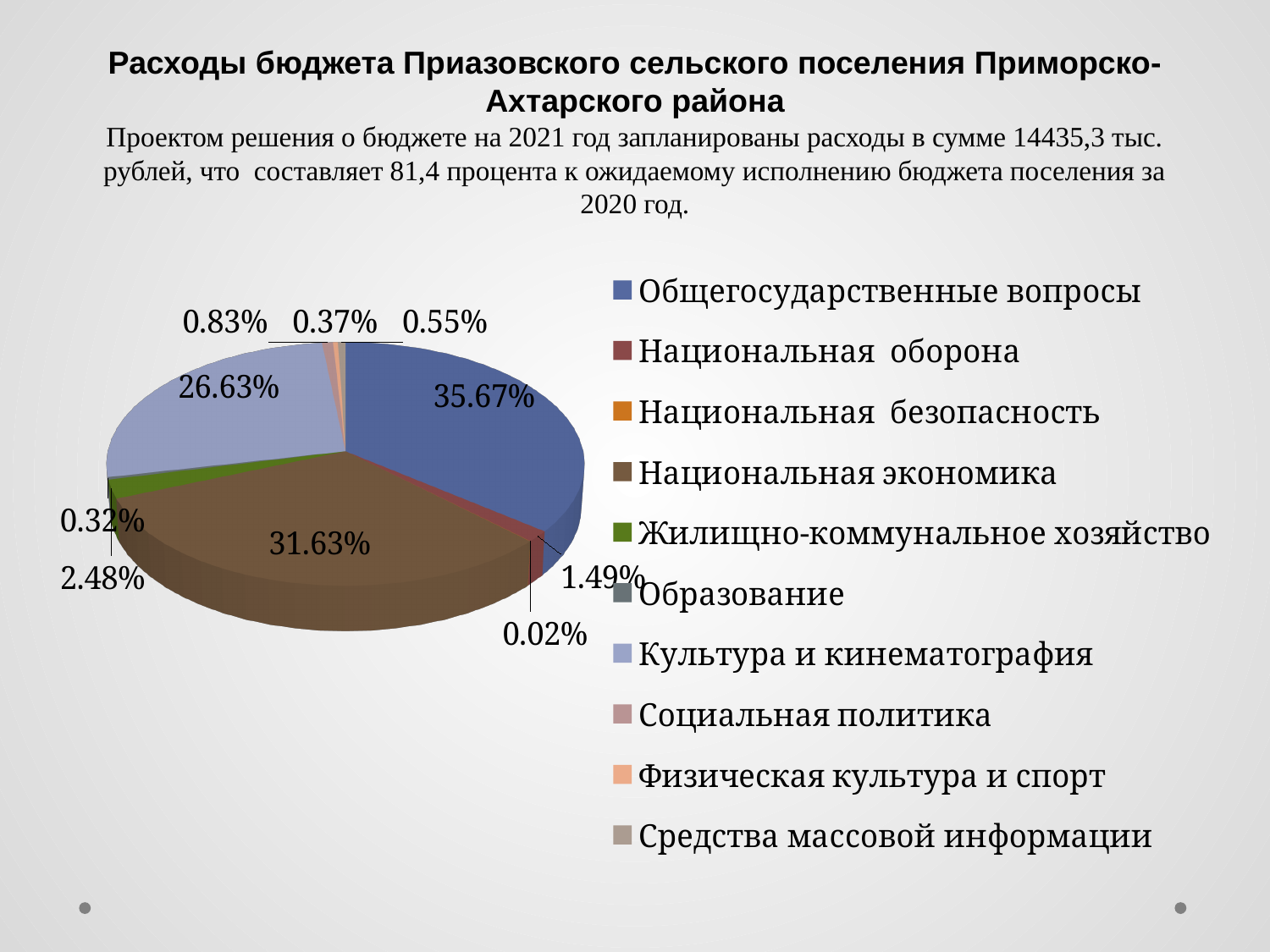
What is the value shown for Национальная оборона? 1.49% How many categories does the legend of the pie chart list? 10 Which category has the largest slice of the pie? Общегосударственные вопросы What is the value shown for Национальная экономика? 31.63% What share of the pie does Общегосударственные вопросы take? 35.67% What is the difference between the shares of Общегосударственные вопросы and Национальная экономика? 4.04% What is the value shown for Жилищно-коммунальное хозяйство? 2.48% What kind of chart is shown on the slide? pie chart Which is larger: the share of Национальная экономика or the share of Культура и кинематография? Национальная экономика Which category has the smallest slice of the pie? Национальная безопасность What is the value shown for Культура и кинематография? 26.63% What colour is the slice for Национальная экономика? brown